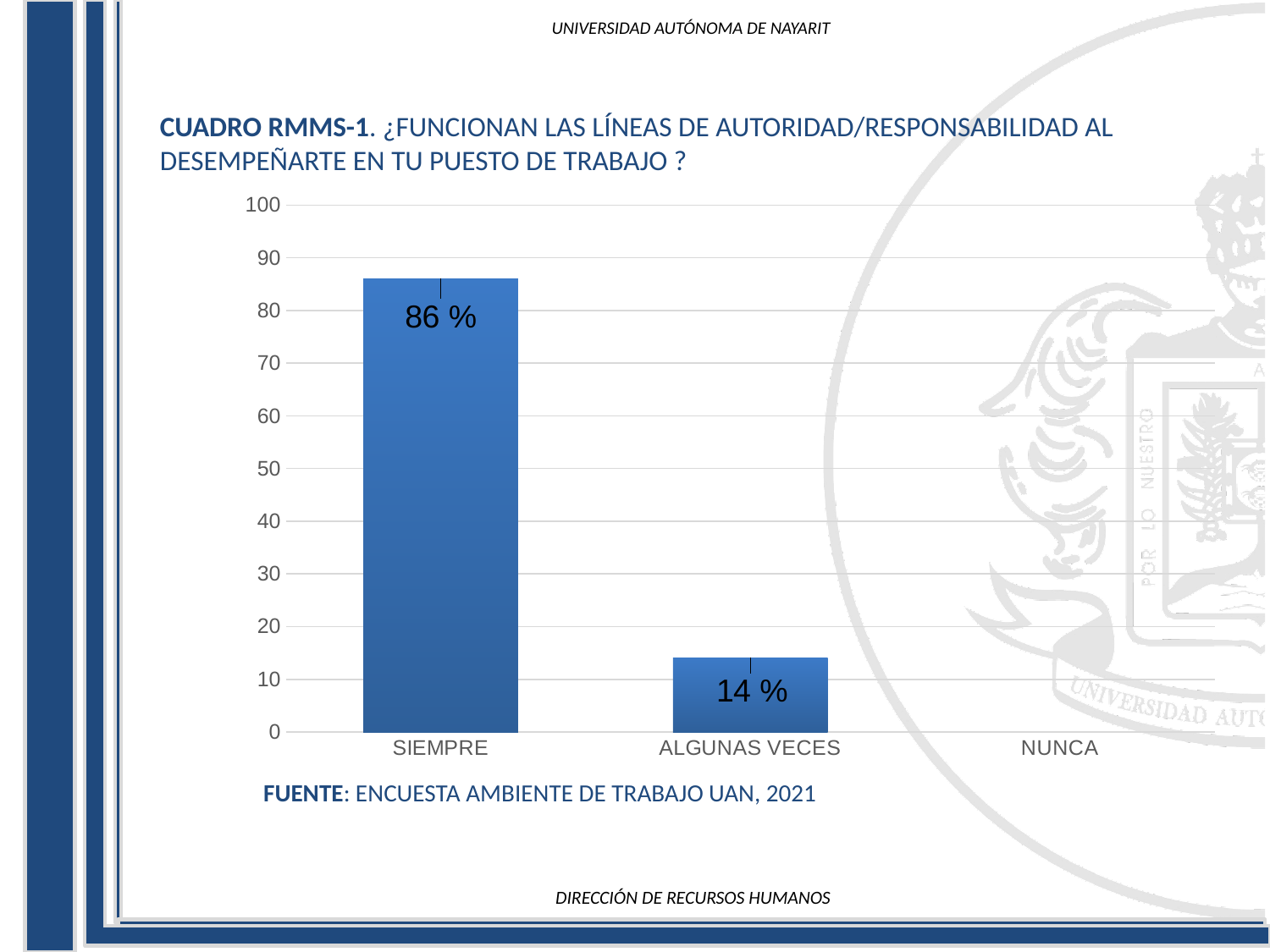
What is the value for ALGUNAS VECES? 14 % Which category has the highest value? SIEMPRE How many categories are shown on the x axis? 3 What is the label of the third category on the x axis? NUNCA What kind of chart is shown on the slide? bar chart Which is larger, the value for SIEMPRE or the value for ALGUNAS VECES? SIEMPRE What is the source cited below the chart? ENCUESTA AMBIENTE DE TRABAJO UAN, 2021 What is the value for SIEMPRE? 86 % Is the value for ALGUNAS VECES greater or less than 20? less Is the value for SIEMPRE greater or less than 80? greater Do the values rise or fall from SIEMPRE to ALGUNAS VECES? fall What is the difference between the values for SIEMPRE and ALGUNAS VECES? 72 %